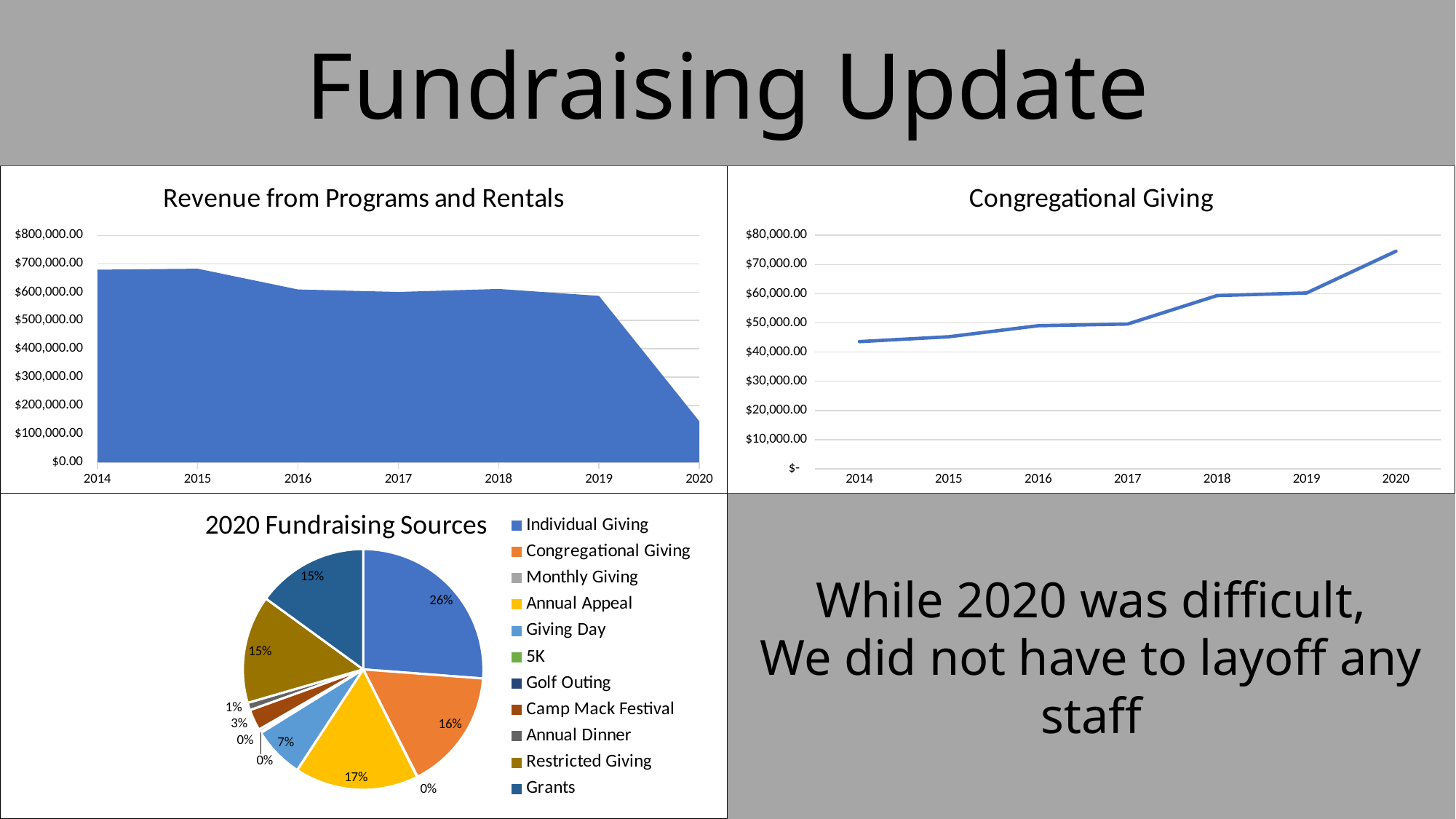
What kind of chart is the "Congregational Giving" chart? Line chart In the "2020 Fundraising Sources" pie chart, what is the difference in percentage points between Individual Giving and Congregational Giving? 10 percentage points In the "2020 Fundraising Sources" pie chart, what share does Individual Giving have? 26% In the "Congregational Giving" chart, do the values generally rise or fall from 2014 to 2020? Rise In the "Congregational Giving" chart, is the value for 2020 greater or less than $70,000.00? greater In the "Revenue from Programs and Rentals" chart, which year has the lowest revenue? 2020 In the "Congregational Giving" chart, which year has the highest value? 2020 In the "Revenue from Programs and Rentals" chart, how many years are shown on the x axis? 7 What kind of chart is the "Revenue from Programs and Rentals" chart? Area chart In the "2020 Fundraising Sources" pie chart, what share does Annual Appeal have? 17% In the "Revenue from Programs and Rentals" chart, is the value for 2020 greater or less than $200,000.00? less How many entries does the legend of the "2020 Fundraising Sources" chart list? 11